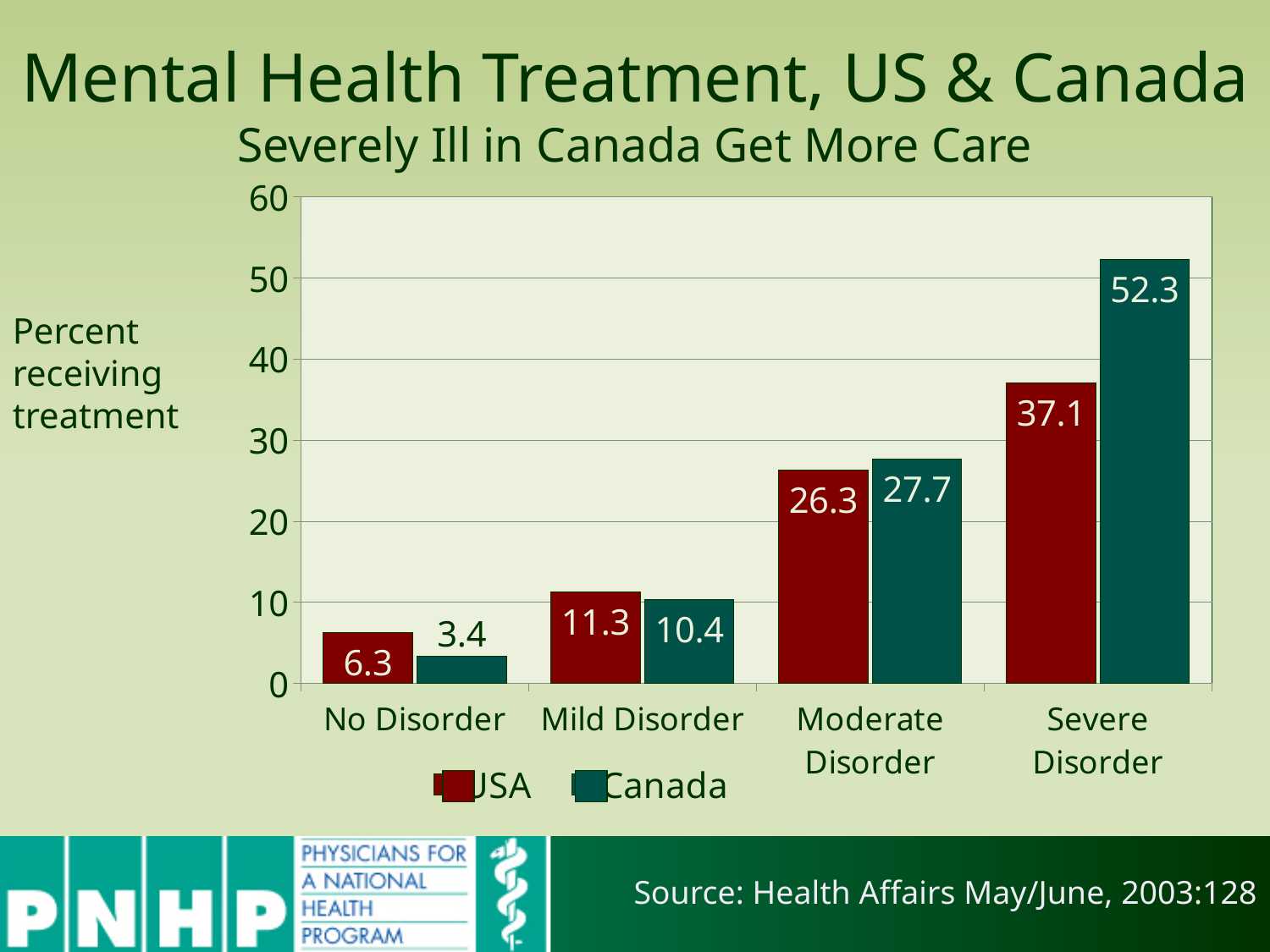
Do the Canada values rise or fall from No Disorder to Severe Disorder? rise How many disorder categories are shown on the x axis? 4 Which is larger in the Mild Disorder category, the USA value or the Canada value? USA What is the percent receiving treatment for Canada in the No Disorder category? 3.4 How many series does the legend list? 2 What kind of chart is shown on the slide? bar chart What is the difference between the Canada and USA values in the Severe Disorder category? 15.2 Which category has the highest value for Canada? Severe Disorder What is the value for Canada in the Moderate Disorder category? 27.7 Which category has the lowest value for the USA? No Disorder What is the percent receiving treatment for the USA in the Severe Disorder category? 37.1 Is the Canada value for Severe Disorder greater or less than 50? greater